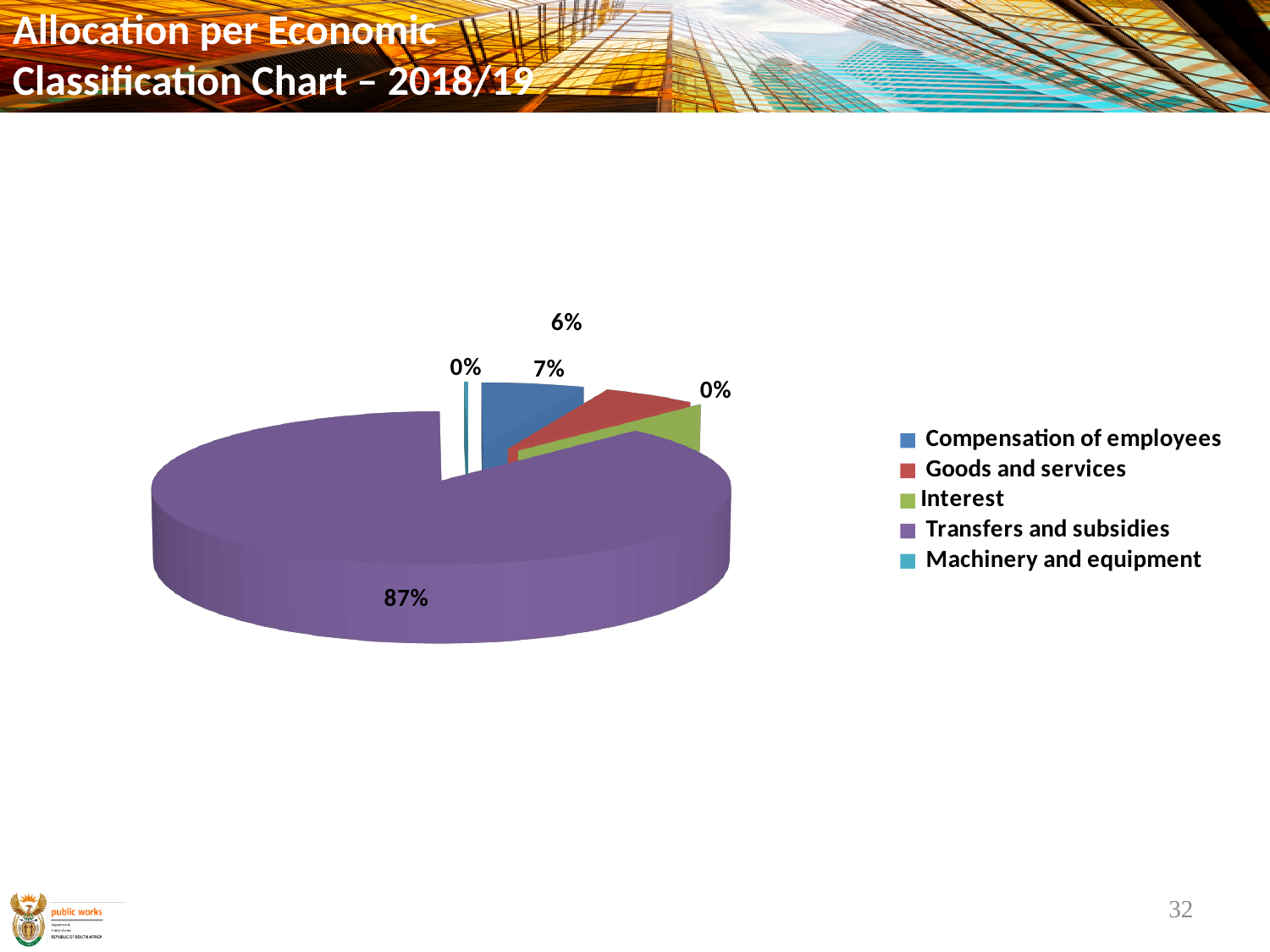
What is the title of the slide containing the chart? Allocation per Economic Classification Chart – 2018/19 What share of the allocation goes to Transfers and subsidies? 87% Which is larger: the share for Transfers and subsidies or the share for Compensation of employees? Transfers and subsidies Which is larger: the share for Goods and services or the share for Interest? Goods and services What colour represents Transfers and subsidies in the chart? Purple What kind of chart is shown on the slide? Pie chart What is the difference between the share for Transfers and subsidies and the share for Interest? 87% What share of the allocation goes to Machinery and equipment? 0% How many economic classifications are listed in the legend? 5 What share of the allocation goes to Interest? 0% Which economic classification has the largest share of the allocation? Transfers and subsidies